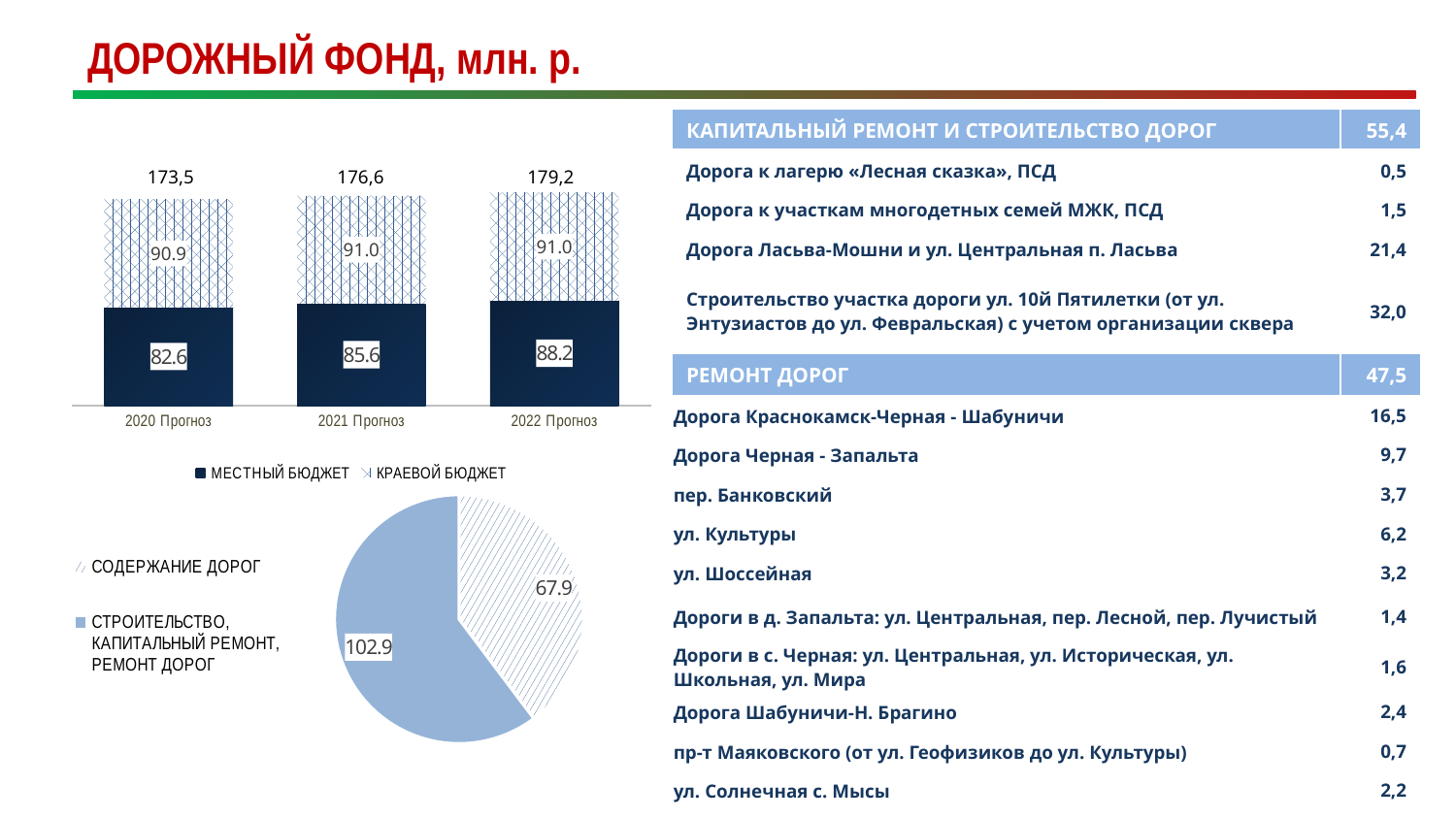
In the stacked bar chart, does the МЕСТНЫЙ БЮДЖЕТ value rise or fall from 2020 Прогноз to 2022 Прогноз? rise In the pie chart, what is the value for СОДЕРЖАНИЕ ДОРОГ? 67.9 In the stacked bar chart, what is the value for МЕСТНЫЙ БЮДЖЕТ in 2020 Прогноз? 82.6 How many categories are shown on the x axis of the stacked bar chart? 3 How many series does the legend of the stacked bar chart list? 2 In the stacked bar chart, which year has the highest total? 2022 Прогноз What type of chart is the chart at the bottom left of the slide? pie chart In the stacked bar chart, what is the difference between the МЕСТНЫЙ БЮДЖЕТ values for 2022 Прогноз and 2020 Прогноз? 5.6 In the pie chart, which slice is larger: СОДЕРЖАНИЕ ДОРОГ or СТРОИТЕЛЬСТВО, КАПИТАЛЬНЫЙ РЕМОНТ, РЕМОНТ ДОРОГ? СТРОИТЕЛЬСТВО, КАПИТАЛЬНЫЙ РЕМОНТ, РЕМОНТ ДОРОГ In the stacked bar chart, which year has the lowest value for МЕСТНЫЙ БЮДЖЕТ? 2020 Прогноз In the stacked bar chart, what is the value for КРАЕВОЙ БЮДЖЕТ in 2022 Прогноз? 91.0 In the stacked bar chart, what is the total shown above the 2021 Прогноз bar? 176,6